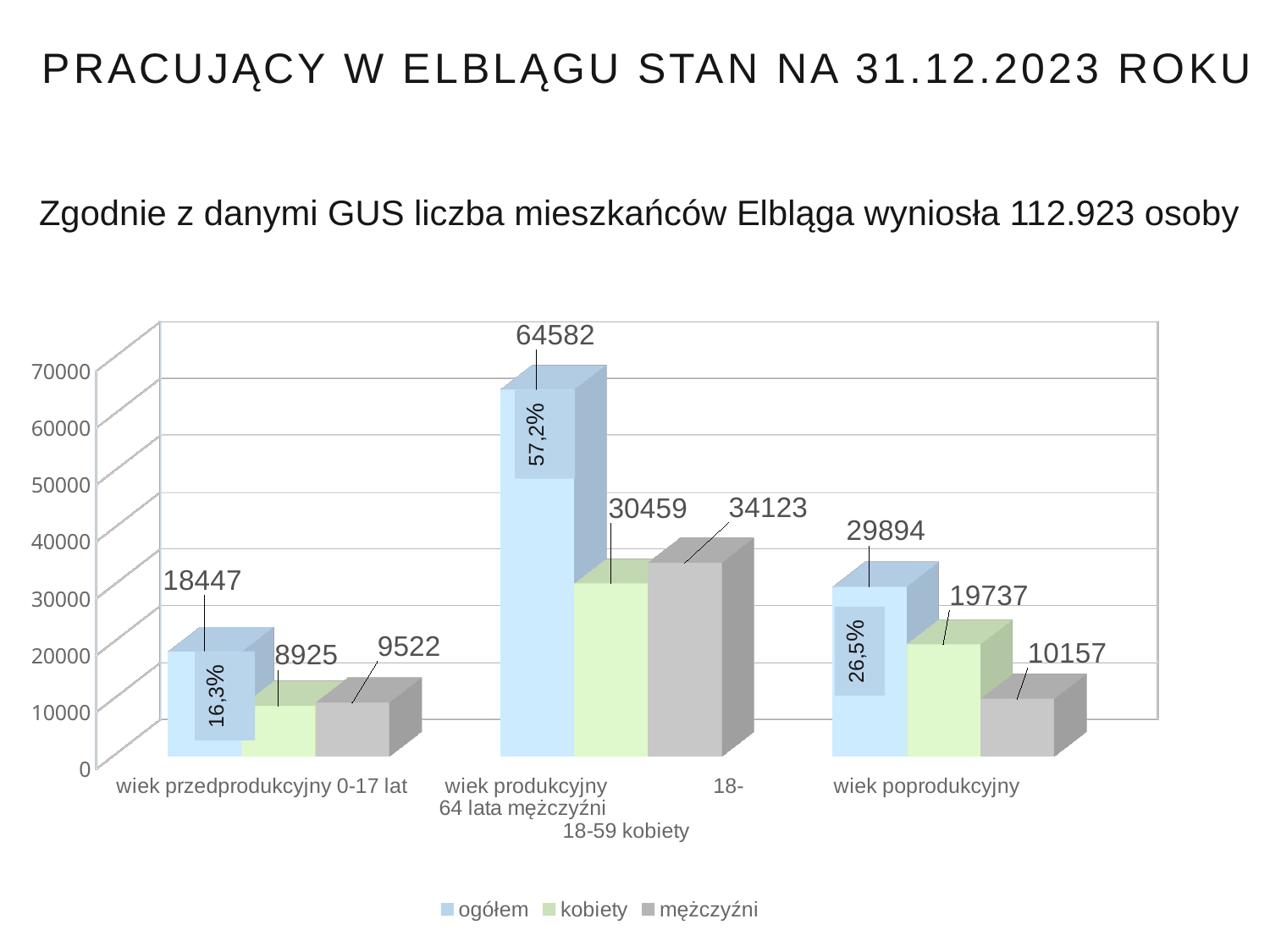
What is the difference between mężczyźni and kobiety for wiek produkcyjny? 3664 What percentage label is shown on the ogółem bar for wiek poprodukcyjny? 26,5% Which is larger for wiek poprodukcyjny, kobiety or mężczyźni? kobiety What kind of chart is shown on the slide? bar chart How many series does the legend list? 3 Which category has the lowest kobiety value? wiek przedprodukcyjny 0-17 lat What is the value of mężczyźni for wiek przedprodukcyjny 0-17 lat? 9522 What is the value of kobiety for wiek poprodukcyjny? 19737 Is the ogółem value for wiek przedprodukcyjny 0-17 lat greater or less than 20000? less How many categories are shown on the x axis? 3 Which category has the highest ogółem value? wiek produkcyjny What is the value of ogółem for wiek produkcyjny? 64582